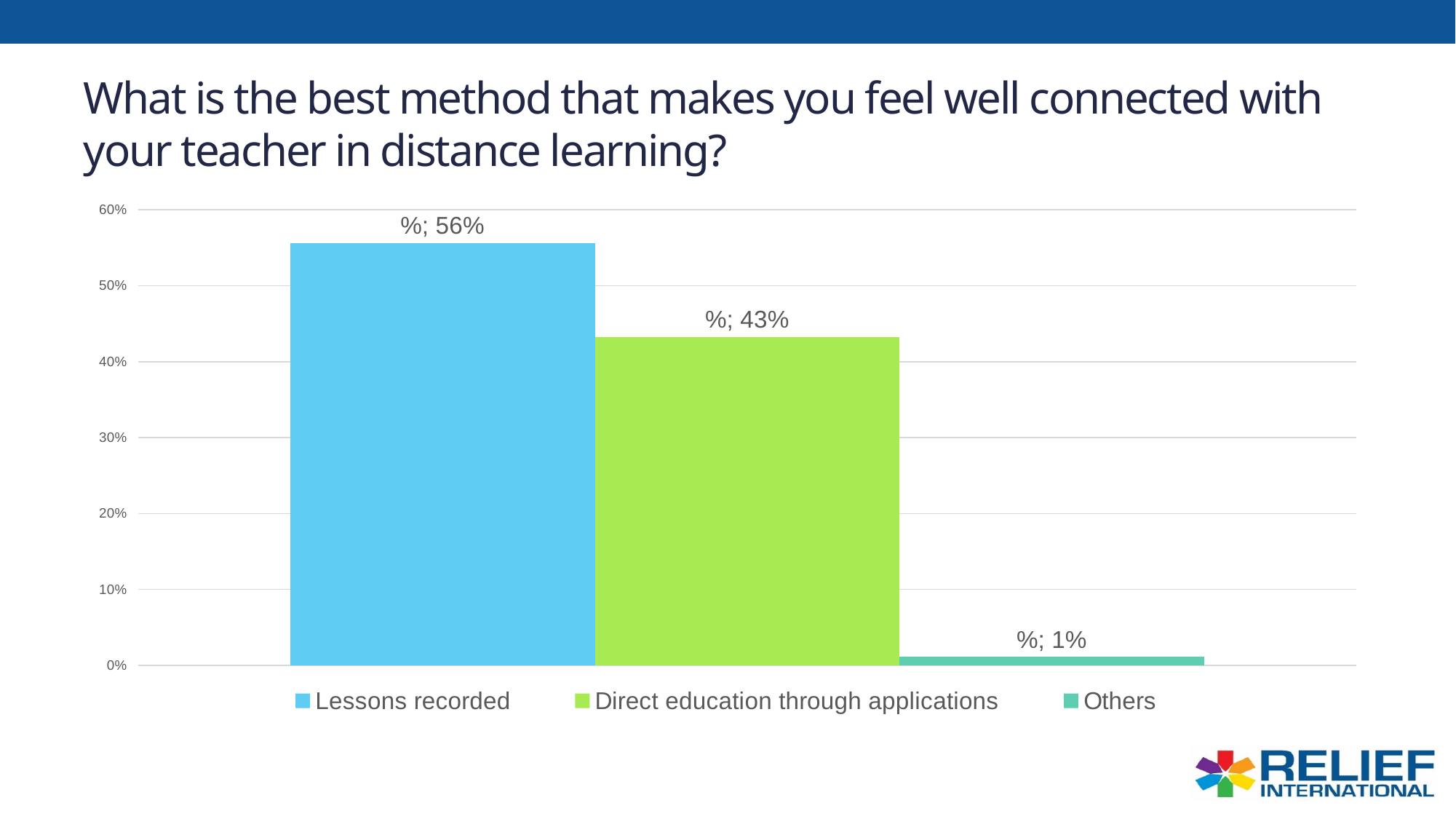
Which method has the lowest percentage? Others How many methods are shown in the chart? 3 What kind of chart is shown on the slide? bar chart Is the value for Direct education through applications greater or less than 50%? less Which method has the highest percentage? Lessons recorded What percentage of respondents chose Direct education through applications? 43% What colour is the bar for Lessons recorded? light blue How many entries does the legend list? 3 What percentage of respondents chose Lessons recorded? 56% Which is larger, the value for Direct education through applications or the value for Others? Direct education through applications What is the difference in percentage points between Lessons recorded and Direct education through applications? 13 What percentage of respondents chose Others? 1%